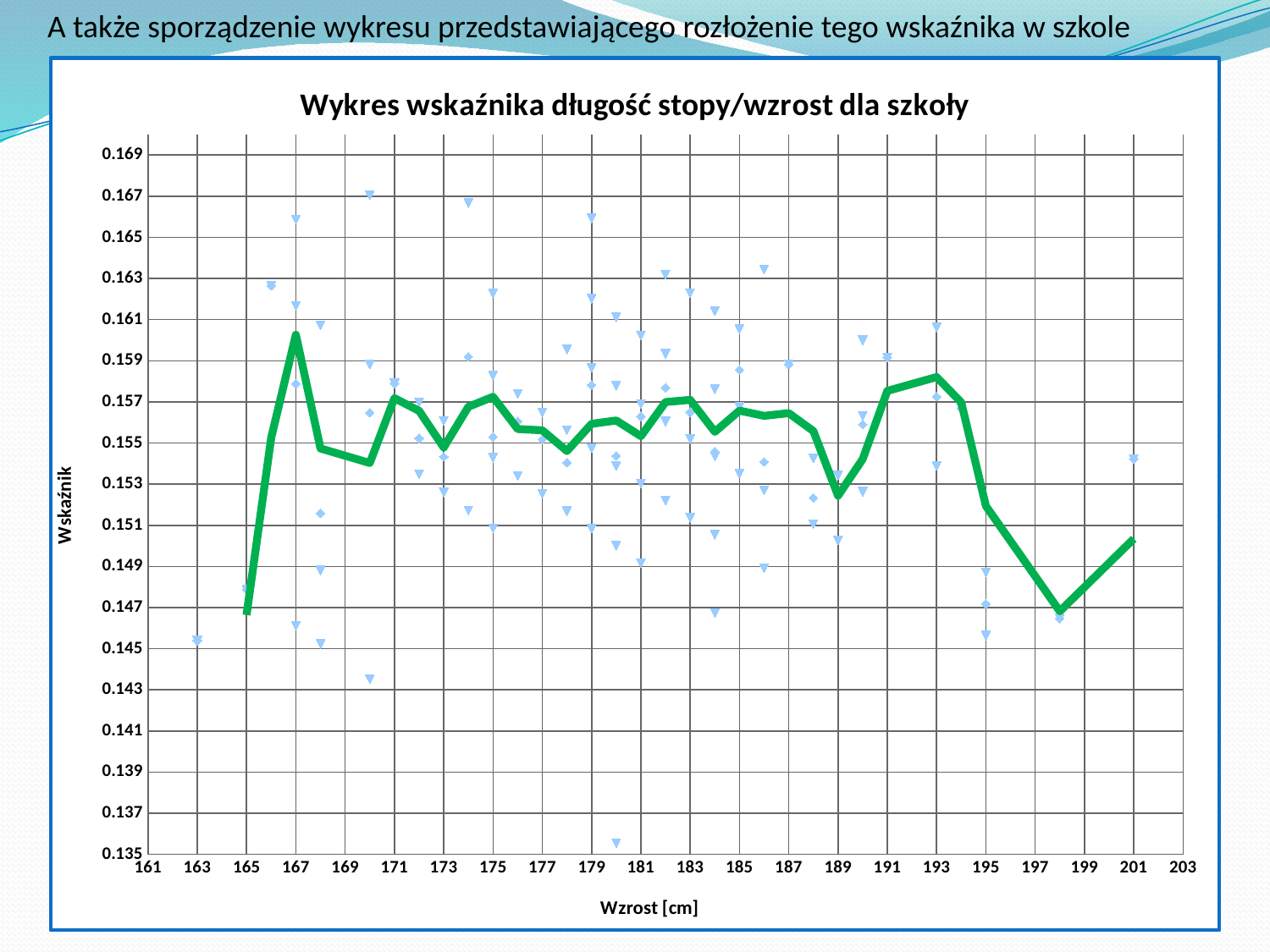
Is the value of the green line at height 198 greater or less than 0.149? less Is the value of the green line at height 193 greater or less than 0.155? greater What is the label of the x axis? Wzrost [cm] Is the value of the green line at height 167 greater or less than 0.159? greater At which height (Wzrost) does the green line reach its highest value? 167 What kind of chart is shown on the slide? Scatter chart with a line What is the title of the chart? Wykres wskaźnika długość stopy/wzrost dla szkoły Which has the larger green-line value: height 191 or height 189? 191 Does the green line rise or fall between height 165 and height 167? rise Does the green line rise or fall between height 193 and height 198? fall